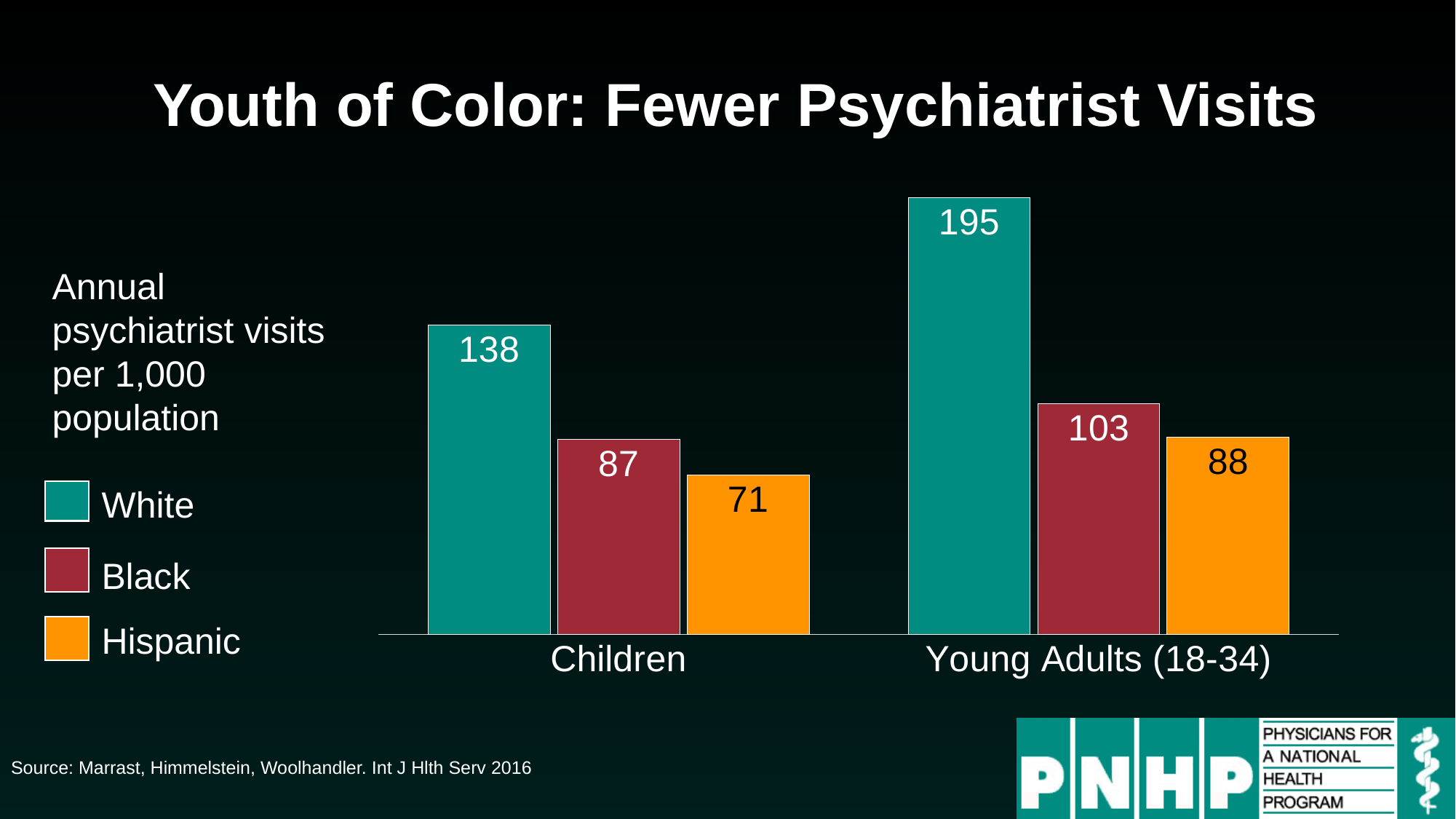
Which group has the lowest annual psychiatrist visit rate on the chart? Hispanic children What is the annual psychiatrist visit rate per 1,000 population for Hispanic young adults (18-34)? 88 Which group has the highest annual psychiatrist visit rate on the chart? White young adults (18-34) How many age categories are shown on the x axis? 2 What is the annual psychiatrist visit rate per 1,000 population for White children? 138 How many series does the legend list? 3 What is the difference between the White and Black values for young adults (18-34)? 92 What kind of chart is shown on the slide? Bar chart What is the difference between the White and Hispanic values for children? 67 Which colour represents the Hispanic series in the legend? Orange Which is larger: the Black value for children or the Hispanic value for young adults (18-34)? Hispanic value for young adults (18-34) What is the value for Black children? 87